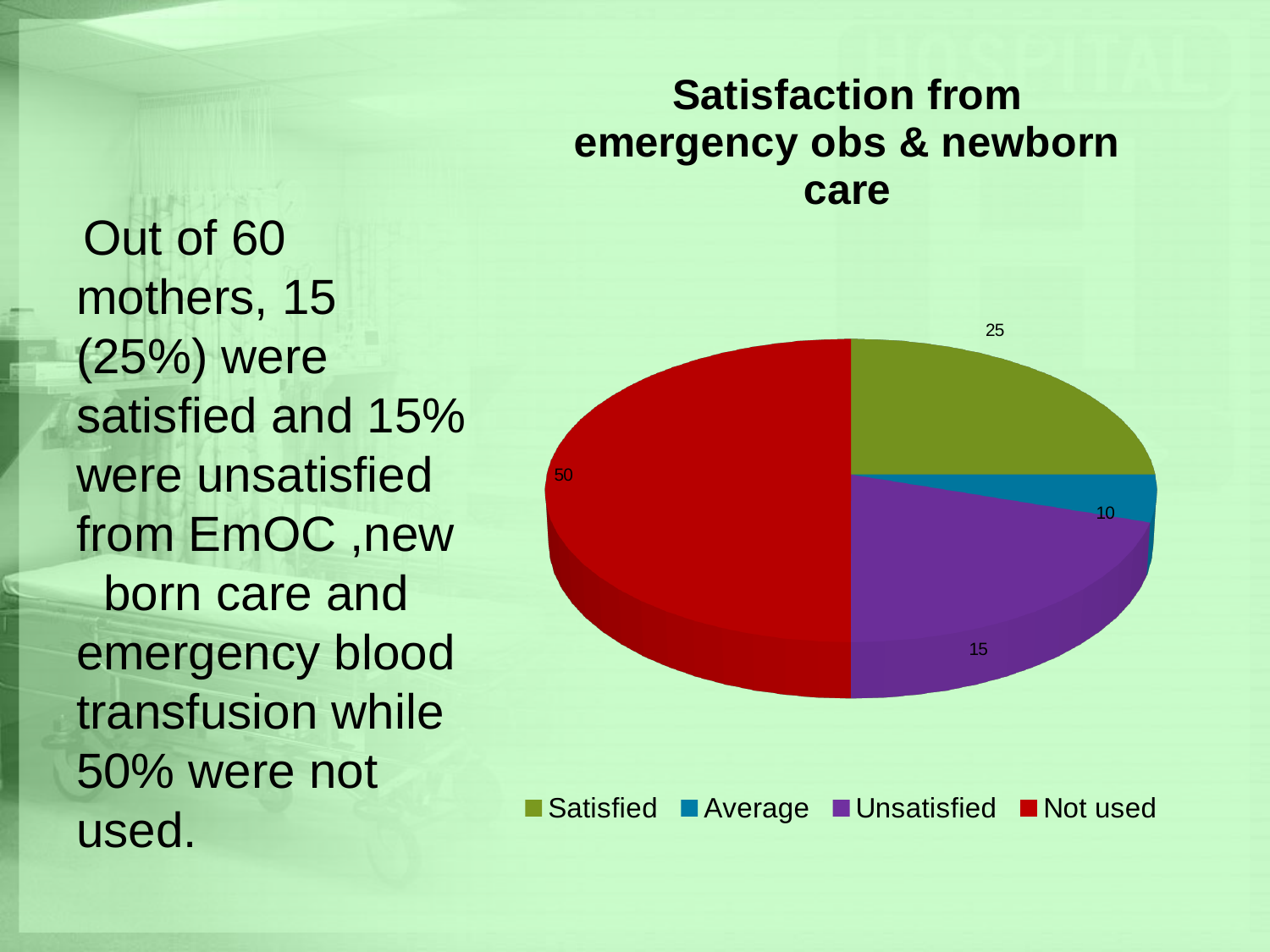
What is the value for Average? 10 What type of chart is shown on the slide? pie chart What is the value for Not used? 50 What is the difference between the values for Not used and Satisfied? 25 Which category has the smallest slice? Average How many categories does the pie chart have? 4 What is the value for Satisfied? 25 What is the title of the chart? Satisfaction from emergency obs & newborn care What is the value for Unsatisfied? 15 What share of the pie does the Not used slice represent? 50% Which category has the largest slice? Not used Which is larger, the value for Satisfied or the value for Unsatisfied? Satisfied